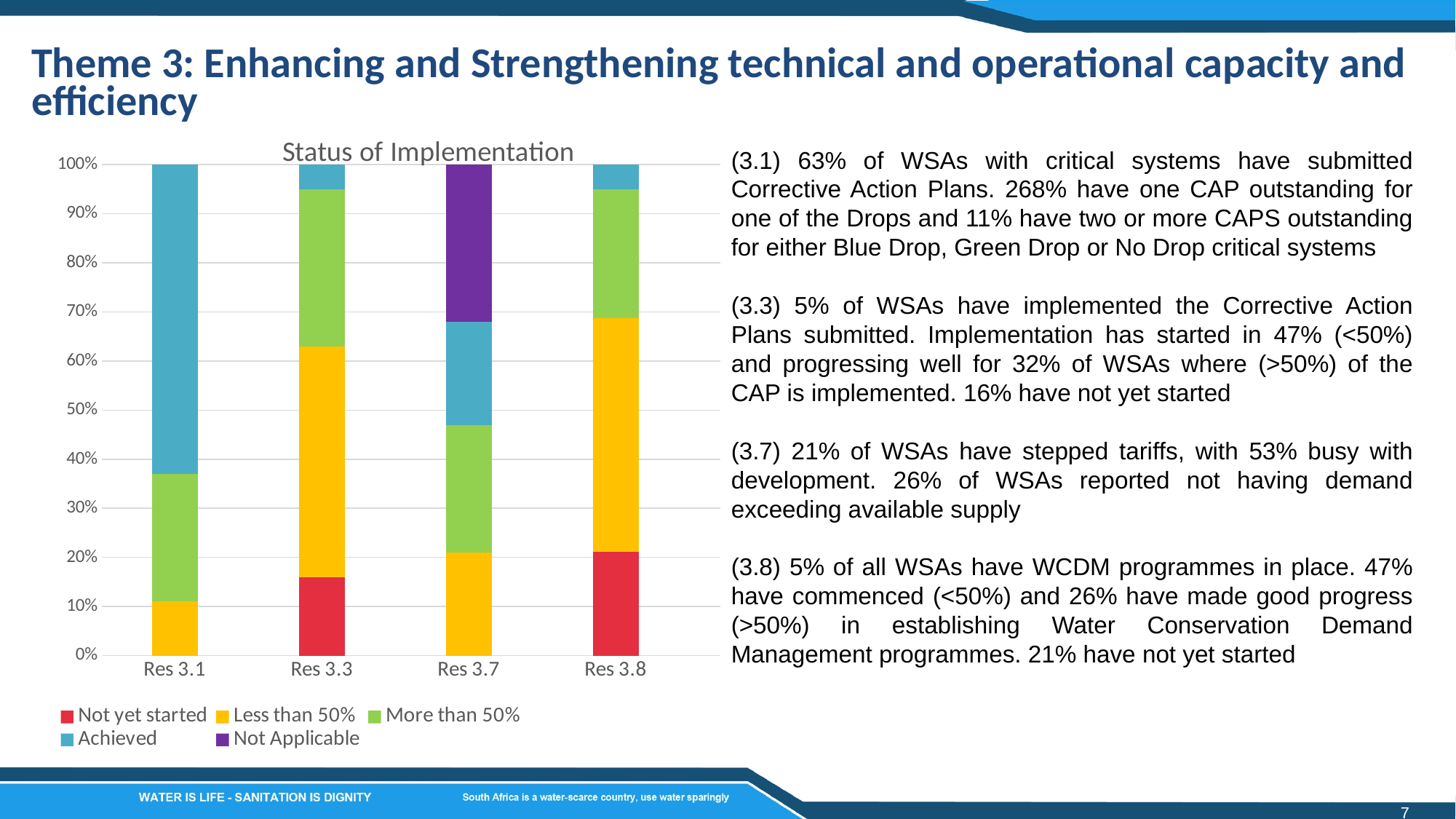
Which category has the largest 'Achieved' segment? Res 3.1 How many series does the chart legend list? 5 What is the title of the chart? Status of Implementation Which category is the only one with a 'Not Applicable' segment? Res 3.7 How many categories are shown on the x axis of the chart? 4 Is the 'Achieved' share for Res 3.1 greater or less than 50%? greater What type of chart is shown on the slide? Stacked bar chart Is the 'Not yet started' share for Res 3.3 greater or less than 30%? less Is the 'Less than 50%' share for Res 3.1 greater or less than 20%? less Which has the larger 'Achieved' share, Res 3.1 or Res 3.8? Res 3.1